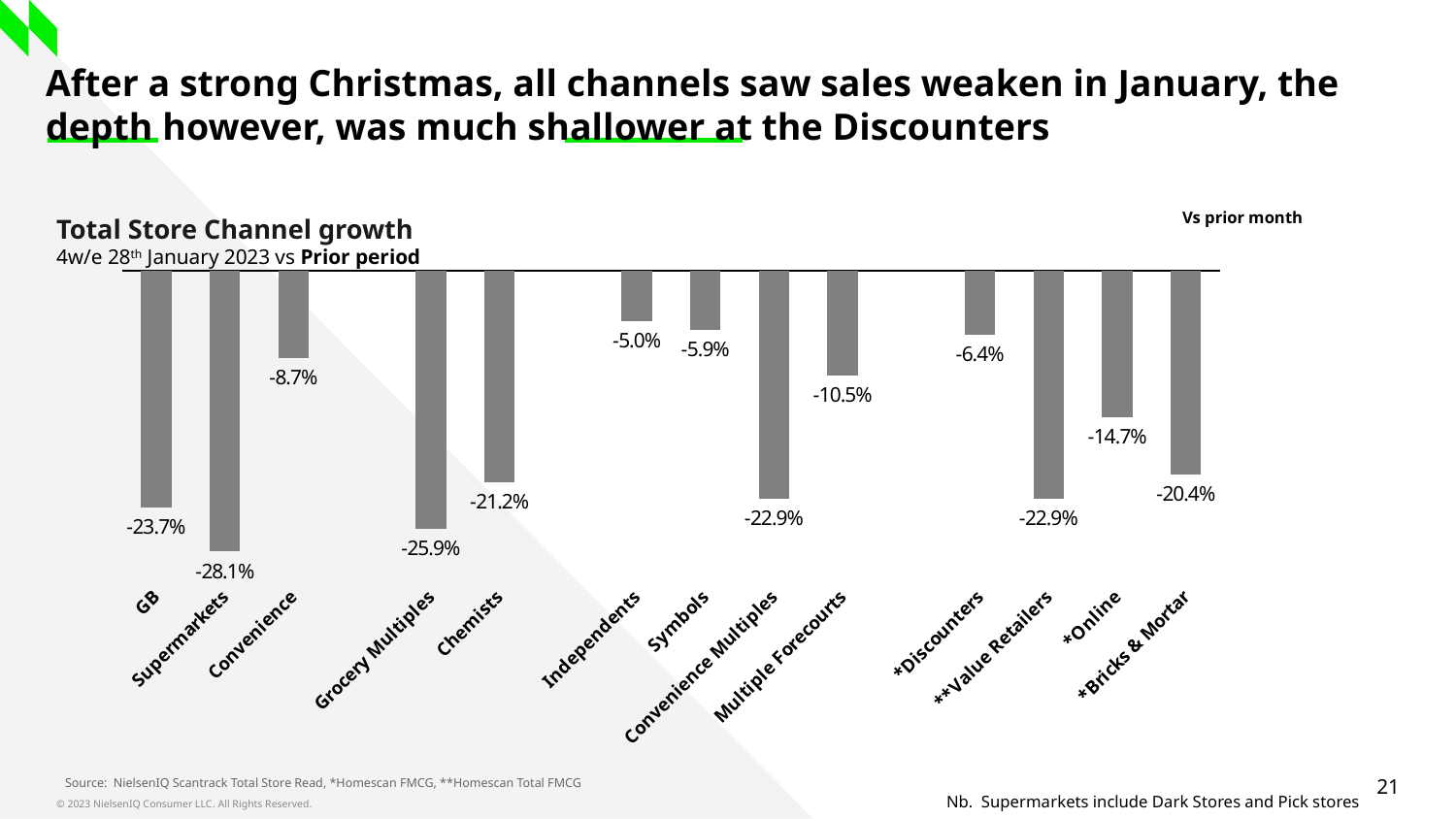
What period does the chart subtitle say the data covers? 4w/e 28th January 2023 vs Prior period What is the value shown for *Online? -14.7% How many channel categories are plotted on the chart? 13 What is the value shown for *Discounters? -6.4% What type of chart is shown on the slide? Bar chart Which has the larger decline, *Online or *Bricks & Mortar? *Bricks & Mortar Which channel shows the largest decline (most negative value)? Supermarkets Which channel shows the smallest decline (least negative value)? Independents What is the title of the chart? Total Store Channel growth What is the value shown for Supermarkets? -28.1% What is the value shown for Multiple Forecourts? -10.5% What is the difference in percentage points between the Supermarkets value (-28.1%) and the Convenience value (-8.7%)? 19.4 percentage points